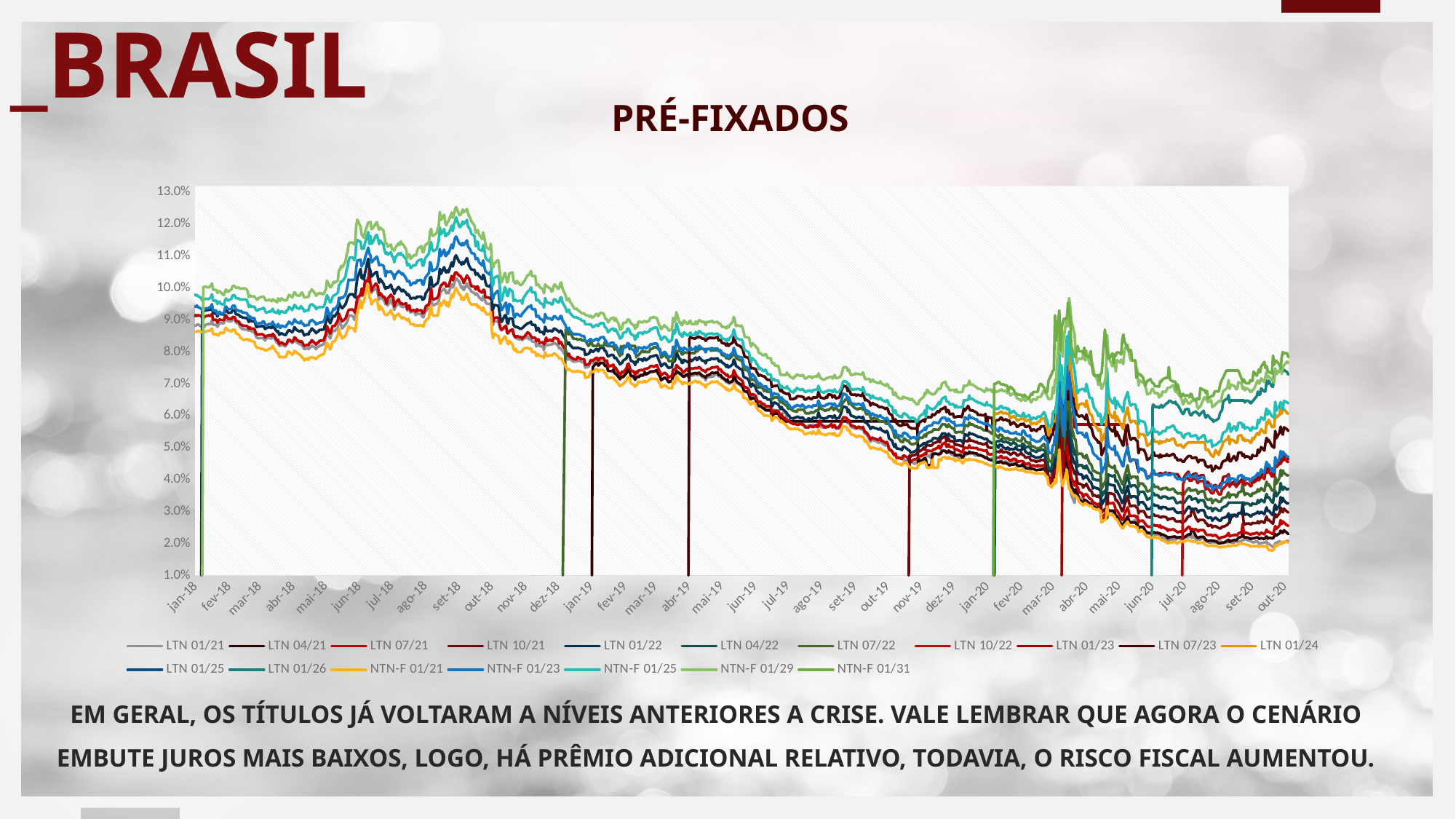
How many series does the chart's legend list? 18 Is the peak value of the highest line around set-18 greater or less than 12.0%? greater What is the highest value shown on the y axis of the chart? 13.0% Is the value of the lowest line at jan-18 greater or less than 8.0%? greater How many month labels are shown along the x axis of the chart? 34 Is the value of the lowest line at out-20 greater or less than 3.0%? less What kind of chart is shown on the slide? line chart Overall, do the plotted yields rise or fall from jan-18 to out-20? fall Do the plotted yields rise or fall between set-18 and out-19? fall What is the title of the chart? PRÉ-FIXADOS